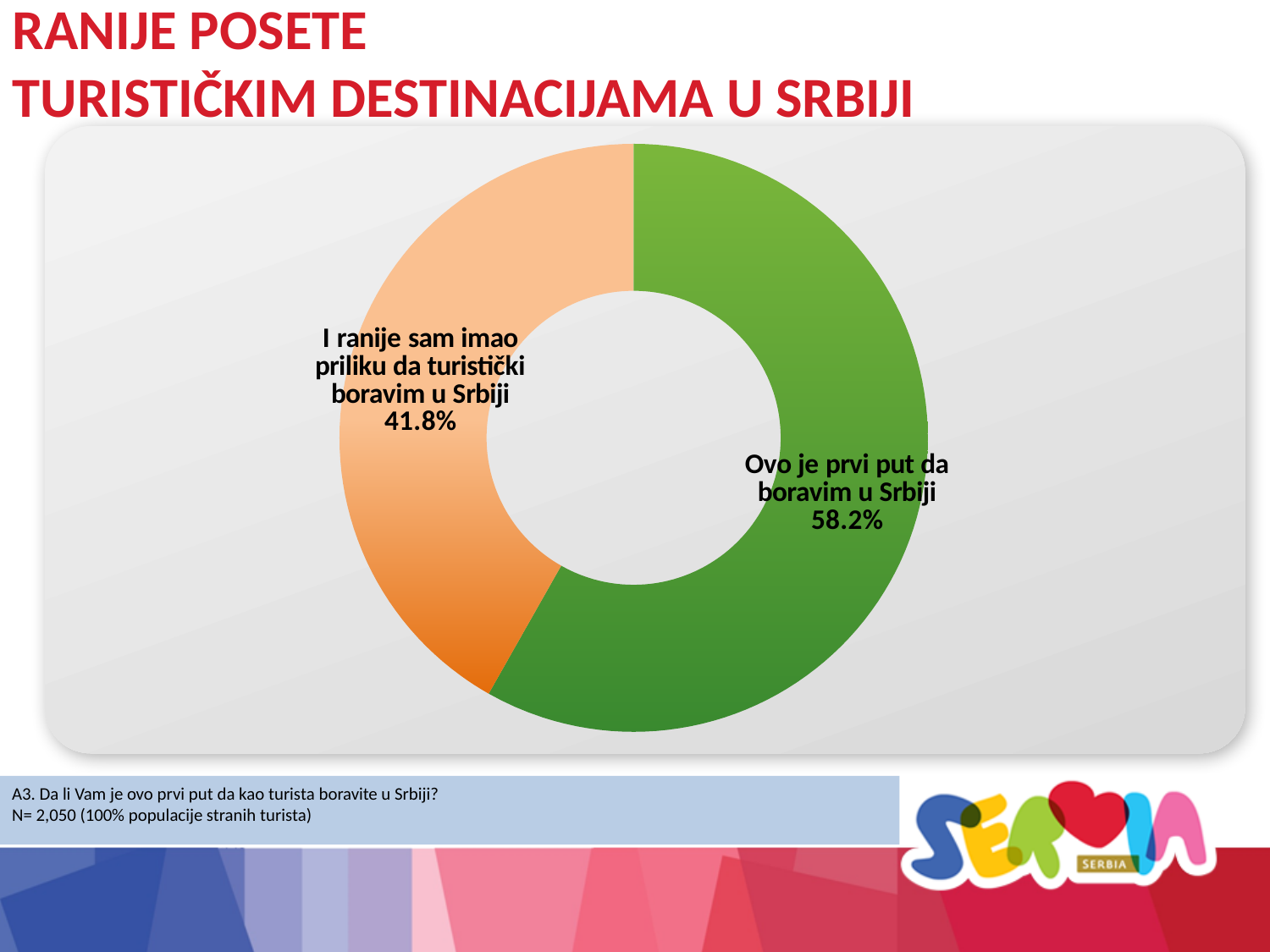
Which category has the smallest share of the chart? I ranije sam imao priliku da turistički boravim u Srbiji What is the difference in percentage points between "Ovo je prvi put da boravim u Srbiji" and "I ranije sam imao priliku da turistički boravim u Srbiji"? 16.4 Which category has the largest share of the chart? Ovo je prvi put da boravim u Srbiji What percentage of respondents answered "I ranije sam imao priliku da turistički boravim u Srbiji"? 41.8% What kind of chart is shown on the slide? Doughnut (pie) chart What is the sample size (N) stated on the slide? 2,050 What share of the chart does the green segment represent? 58.2% What colour is the segment for "I ranije sam imao priliku da turistički boravim u Srbiji"? Orange How many categories are shown in the chart? 2 What percentage of respondents answered "Ovo je prvi put da boravim u Srbiji"? 58.2% Which is larger: the share for "Ovo je prvi put da boravim u Srbiji" or for "I ranije sam imao priliku da turistički boravim u Srbiji"? Ovo je prvi put da boravim u Srbiji